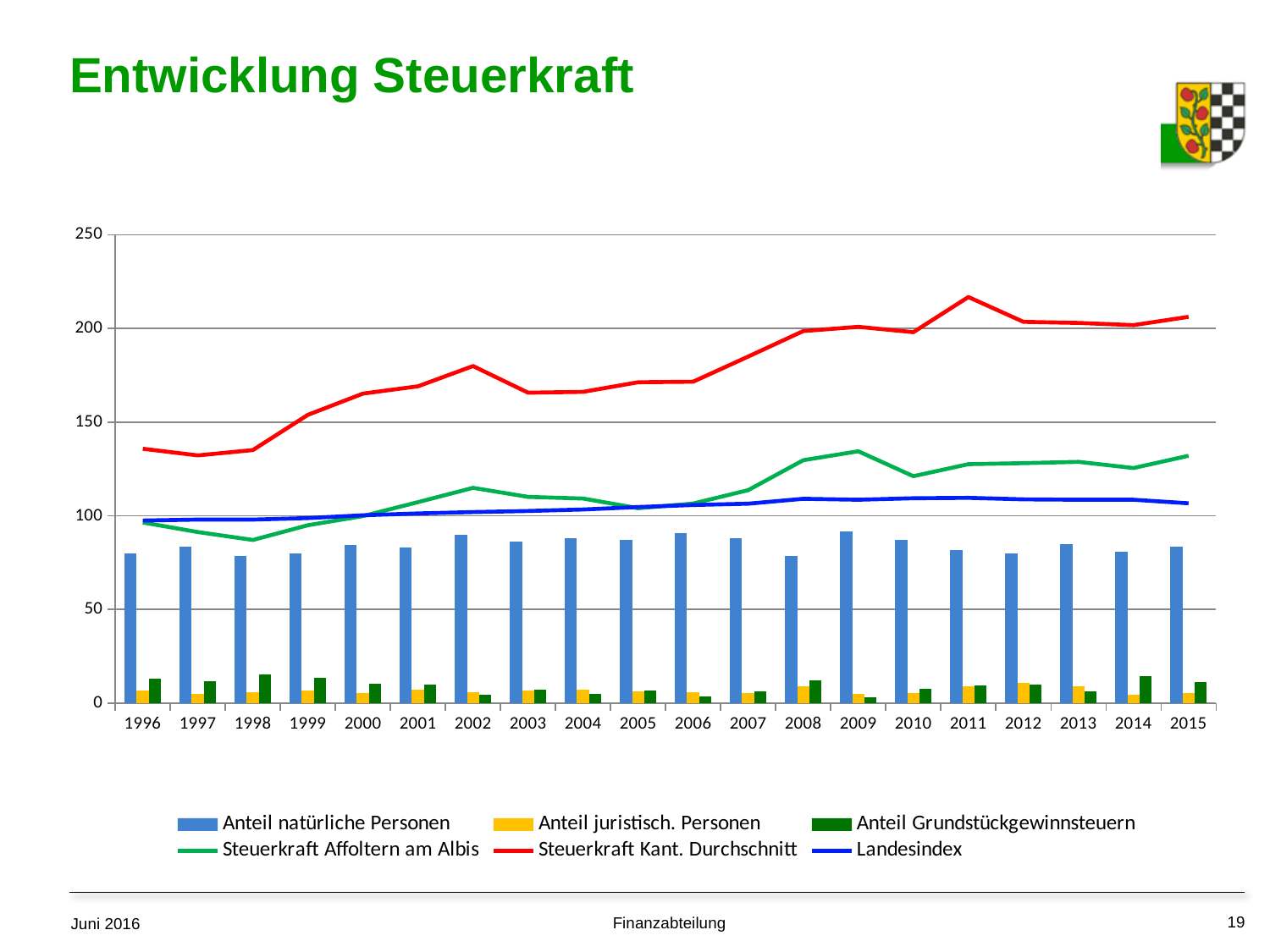
Does the Steuerkraft Kant. Durchschnitt line generally rise or fall from 1996 to 2015? rise Is the value of Steuerkraft Kant. Durchschnitt in 1996 greater or less than 150? less In 2015, which is higher: Steuerkraft Affoltern am Albis or Landesindex? Steuerkraft Affoltern am Albis What is the title of the chart? Entwicklung Steuerkraft What colour is the Landesindex line? Blue In which year does the Steuerkraft Affoltern am Albis line reach its lowest value? 1998 Is the value of Steuerkraft Kant. Durchschnitt in 2011 greater or less than 200? greater How many series does the legend list? 6 Is the value of Steuerkraft Affoltern am Albis in 2009 greater or less than 100? greater In which year does the Steuerkraft Kant. Durchschnitt line reach its highest value? 2011 How many years are shown on the x axis? 20 What kind of chart is this? Combined bar and line chart